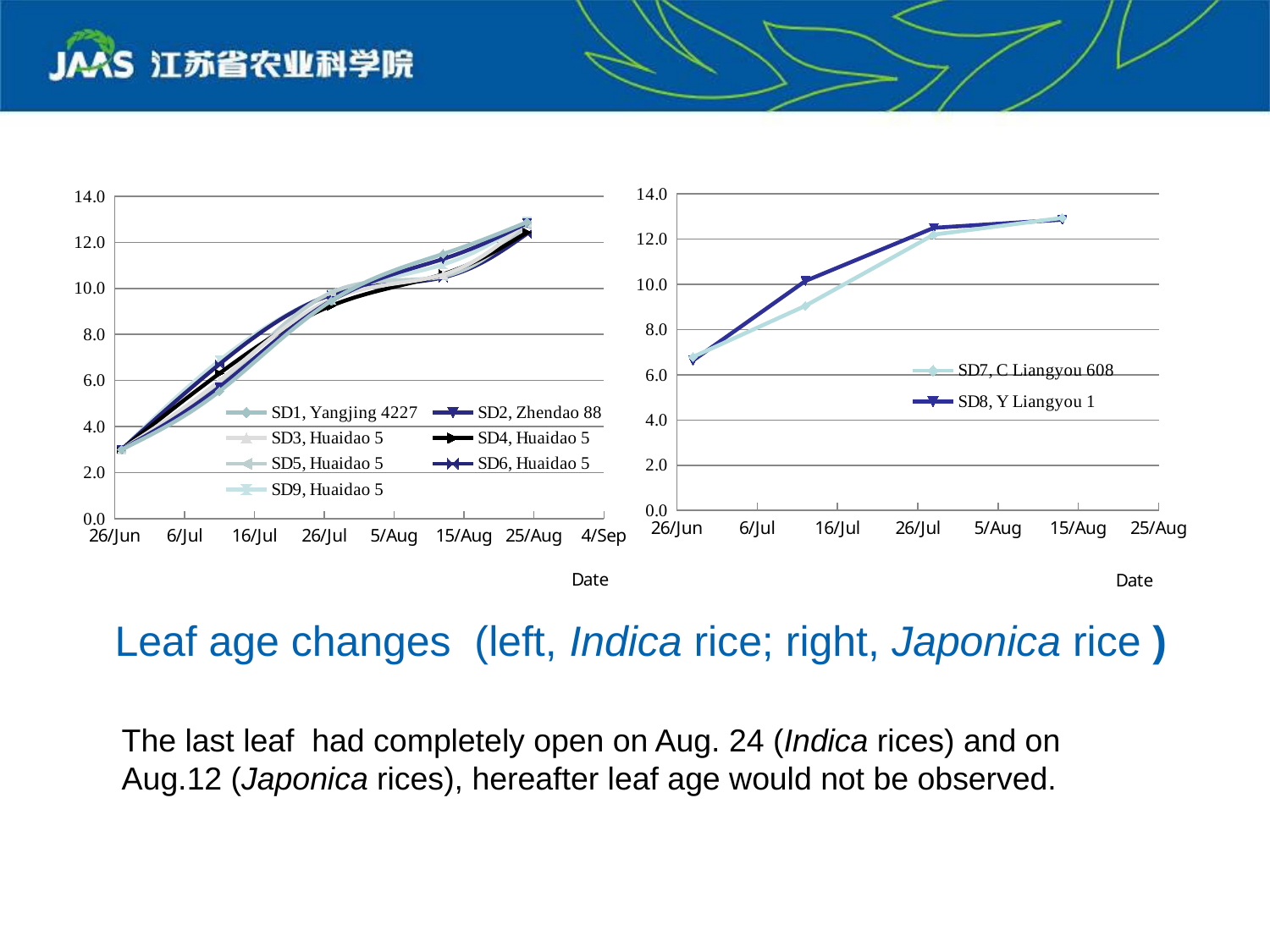
What is the x-axis label of the right chart (Japonica rice)? Date In the right chart (Japonica rice), do the leaf age values rise or fall from 26/Jun to 15/Aug? rise In the left chart (Indica rice), is the value for SD4, Huaidao 5 on 26/Jul greater or less than 10.0? less What kind of chart is the left chart (Indica rice)? line chart In the left chart (Indica rice), do the leaf age values rise or fall along the date axis? rise In the right chart (Japonica rice), is the value for SD7, C Liangyou 608 on 26/Jun greater or less than 6.0? greater How many series does the legend of the left chart (Indica rice) list? 7 How many data points does the SD8, Y Liangyou 1 series have in the right chart (Japonica rice)? 4 In the left chart (Indica rice), is the value for SD4, Huaidao 5 on 26/Jun greater or less than 4.0? less How many series does the legend of the right chart (Japonica rice) list? 2